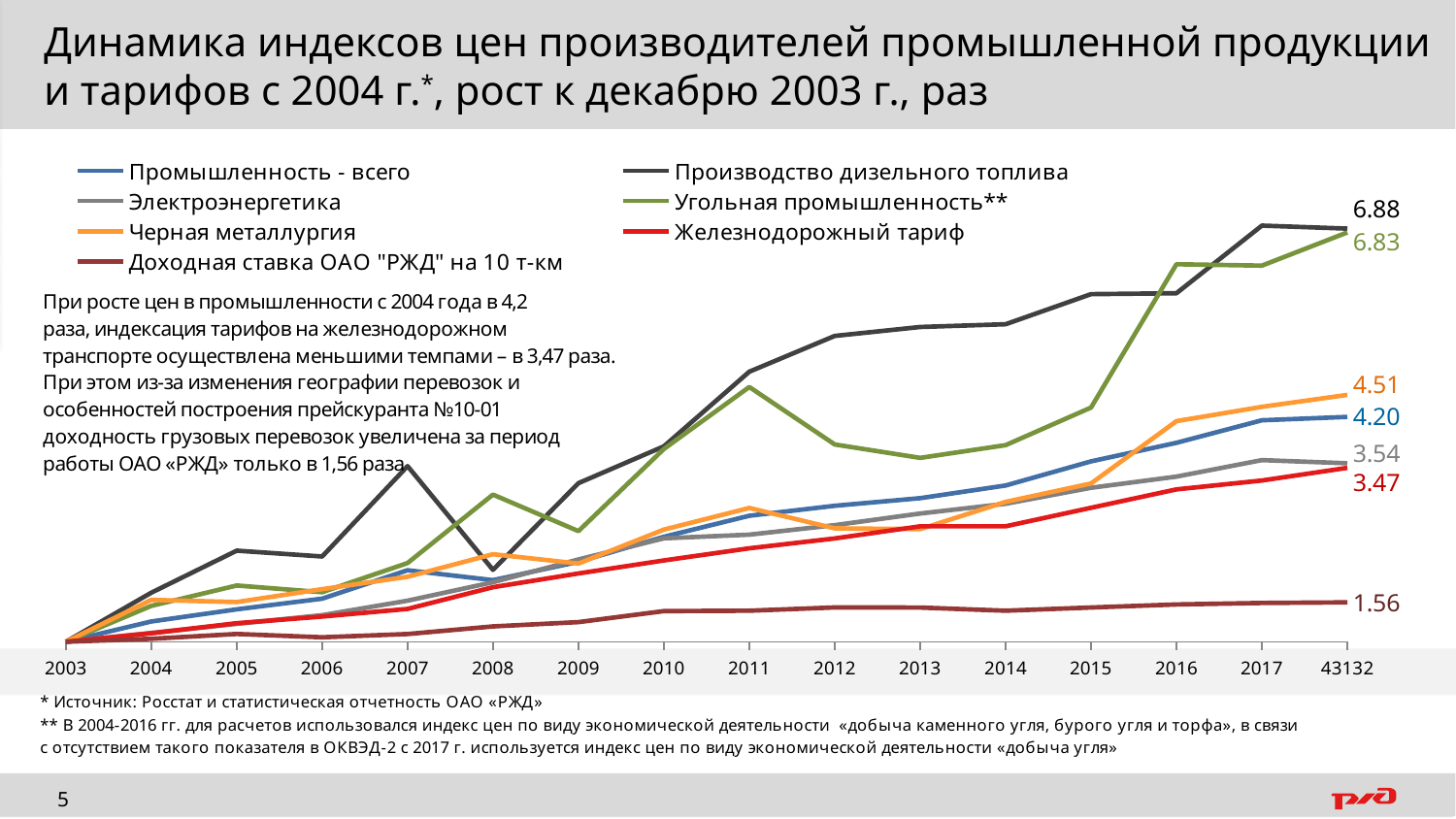
Does the "Железнодорожный тариф" series rise or fall from 2003 to the last point on the x axis? rise What colour is the line for "Угольная промышленность**" in the legend? green What is the final labelled value for the series "Доходная ставка ОАО "РЖД" на 10 т-км"? 1.56 What is the final labelled value for the series "Промышленность - всего"? 4.20 Which has the larger final labelled value: "Черная металлургия" or "Электроэнергетика"? Черная металлургия What is the difference between the final labelled values of "Промышленность - всего" and "Железнодорожный тариф"? 0.73 What type of chart is shown on the slide? line chart Which series has the lowest final labelled value? Доходная ставка ОАО "РЖД" на 10 т-км What is the final labelled value for the series "Угольная промышленность**"? 6.83 What is the final labelled value for the series "Производство дизельного топлива"? 6.88 How many series does the legend list? 7 What is the final labelled value for the series "Железнодорожный тариф"? 3.47